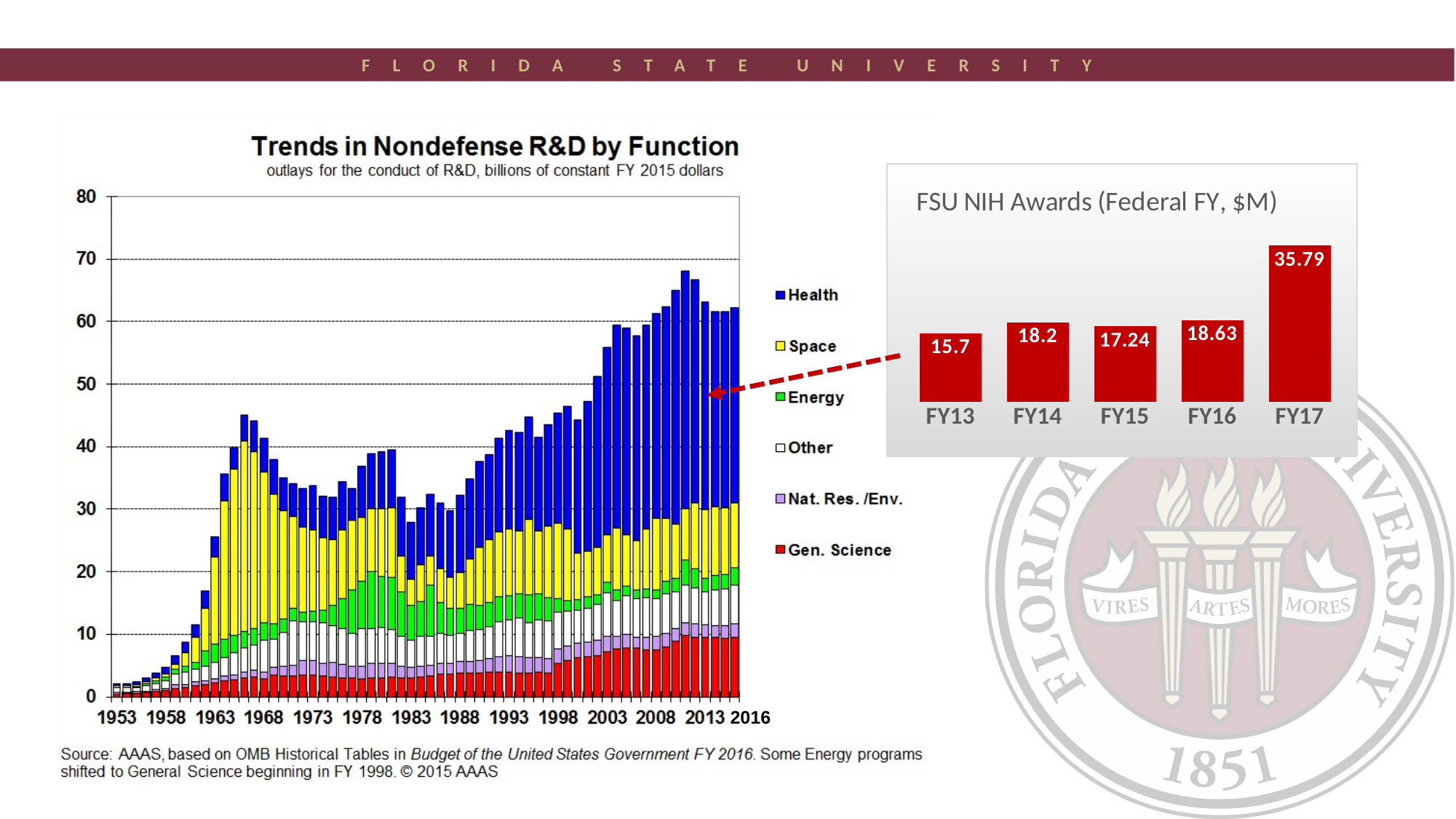
In the Trends in Nondefense R&D by Function chart, is the total for 2013 greater or less than 50? greater In the FSU NIH Awards chart, which fiscal year has the lowest value? FY13 How many fiscal years are shown in the FSU NIH Awards chart? 5 In the Trends in Nondefense R&D by Function chart, which series is shown in blue? Health In the FSU NIH Awards chart, which is larger, the value for FY14 or the value for FY15? FY14 In the FSU NIH Awards chart, which fiscal year has the highest value? FY17 In the FSU NIH Awards chart, what is the value for FY13? 15.7 What kind of chart is the FSU NIH Awards chart? bar chart How many series does the legend of the Trends in Nondefense R&D by Function chart list? 6 In the FSU NIH Awards chart, what is the value for FY15? 17.24 In the FSU NIH Awards chart, what is the value for FY17? 35.79 In the FSU NIH Awards chart, what is the difference between the FY17 and FY16 values? 17.16